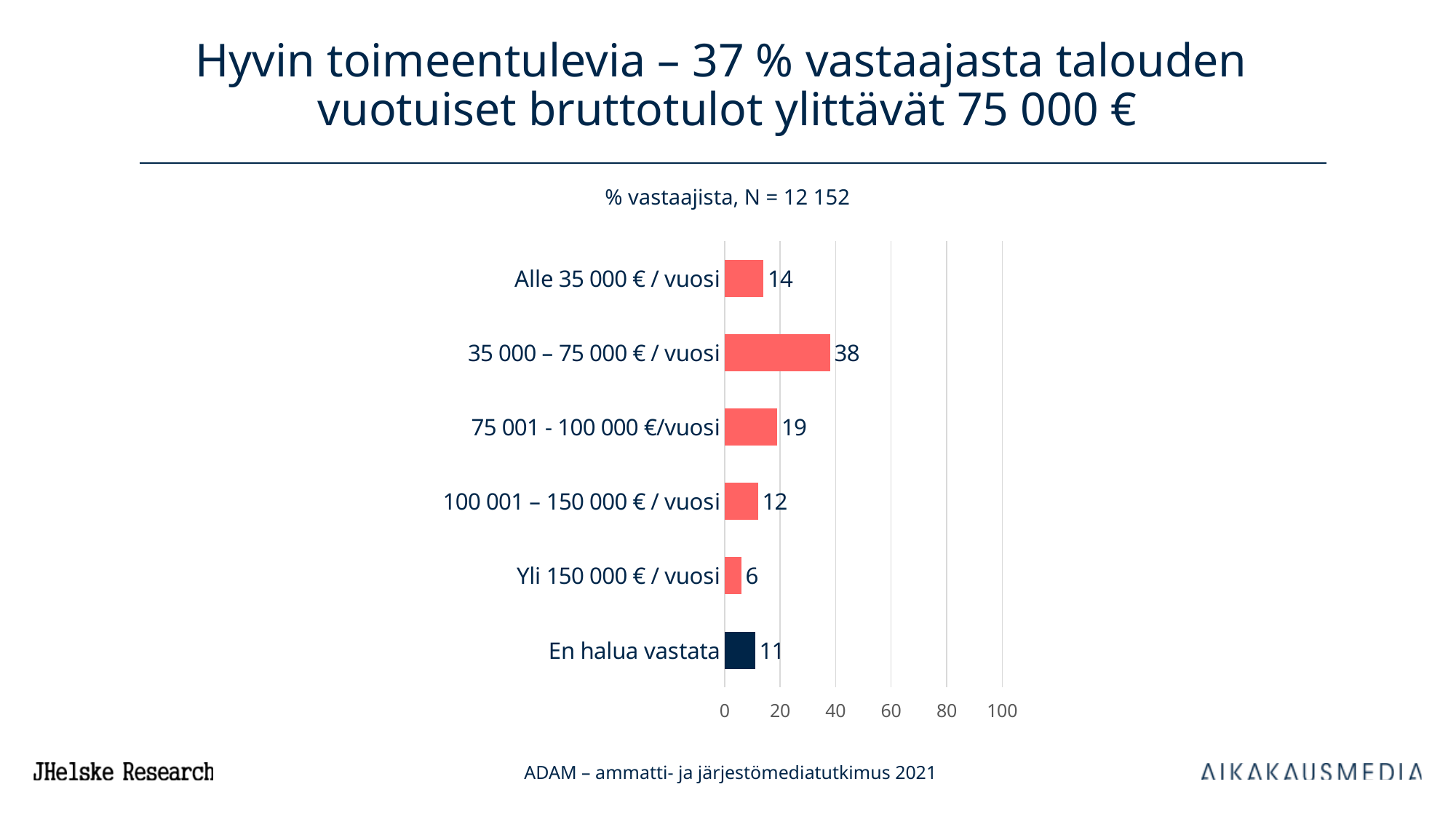
Which is larger, the value for "100 001 – 150 000 € / vuosi" or the value for "Alle 35 000 € / vuosi"? Alle 35 000 € / vuosi What is the value for "75 001 - 100 000 €/vuosi"? 19 What is the difference between the values for "35 000 – 75 000 € / vuosi" and "75 001 - 100 000 €/vuosi"? 19 What is the value for "Alle 35 000 € / vuosi"? 14 Which category has the highest value? 35 000 – 75 000 € / vuosi Which category has the lowest value? Yli 150 000 € / vuosi What is the subtitle text shown above the chart? % vastaajista, N = 12 152 What kind of chart is shown on the slide? bar chart How many categories are shown in the chart? 6 Is the value for "35 000 – 75 000 € / vuosi" greater or less than 20? greater What is the value for "35 000 – 75 000 € / vuosi"? 38 What is the value for "En halua vastata"? 11